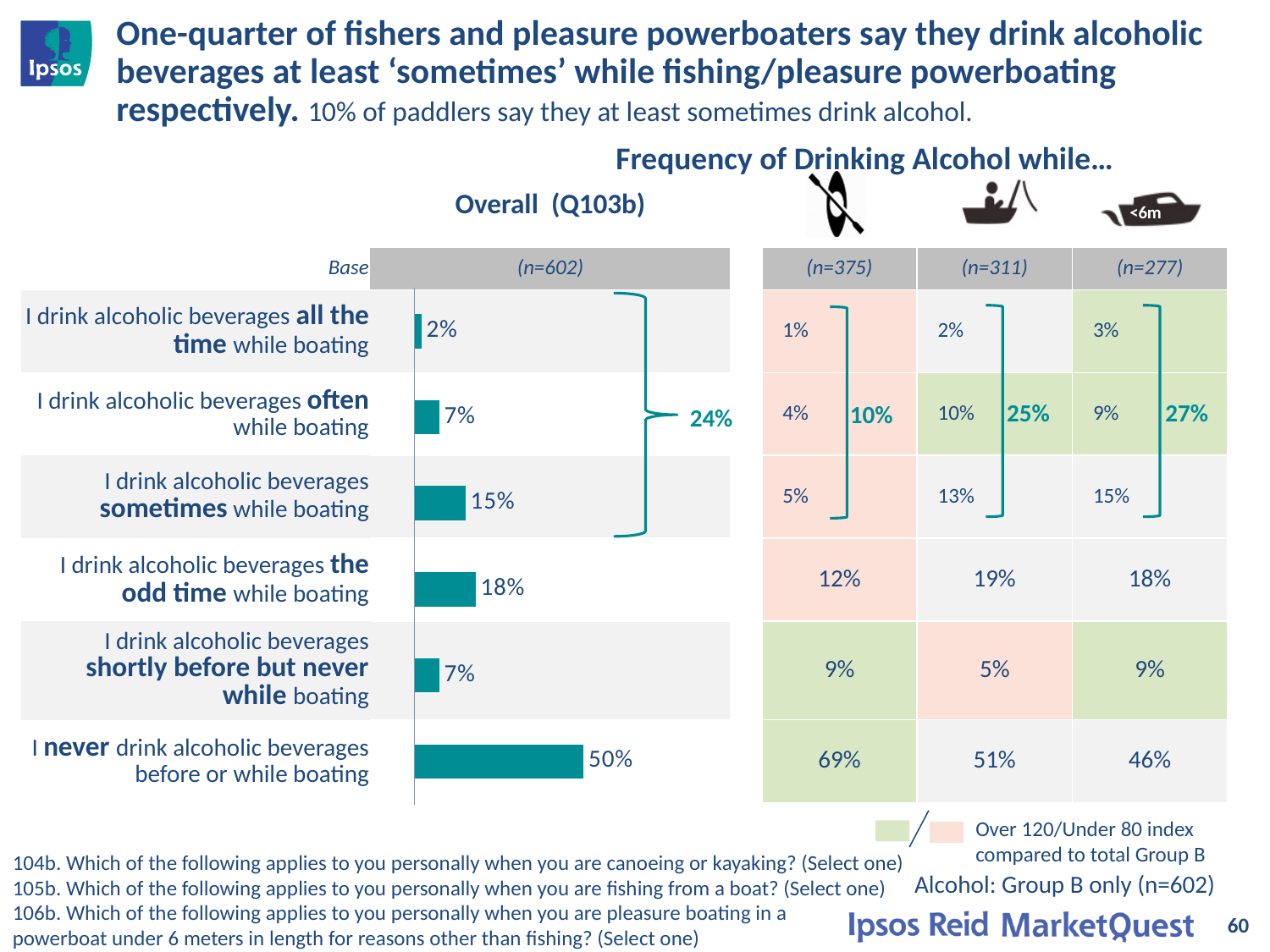
In the Overall (Q103b) bar chart, what is the value for 'I drink alcoholic beverages all the time while boating'? 2% In the Overall (Q103b) chart, what combined percentage is shown by the bracket for 'all the time', 'often' and 'sometimes'? 24% How many categories are shown in the Overall (Q103b) bar chart? 6 In the Overall (Q103b) bar chart, which is larger: the value for 'sometimes' or the value for 'the odd time'? the odd time What is the title shown above the three activity columns to the right of the Overall chart? Frequency of Drinking Alcohol while… In the Overall (Q103b) bar chart, what percentage of respondents say they never drink alcoholic beverages before or while boating? 50% In the Overall (Q103b) bar chart, what is the difference between the 'never' value and the 'the odd time' value? 32% In the Overall (Q103b) bar chart, which category has the highest value? I never drink alcoholic beverages before or while boating In the Overall (Q103b) bar chart, which category has the lowest value? I drink alcoholic beverages all the time while boating What type of chart is the Overall (Q103b) chart? bar chart What is the base size (n) shown for the Overall (Q103b) chart? n=602 In the Overall (Q103b) bar chart, what is the value for 'I drink alcoholic beverages sometimes while boating'? 15%